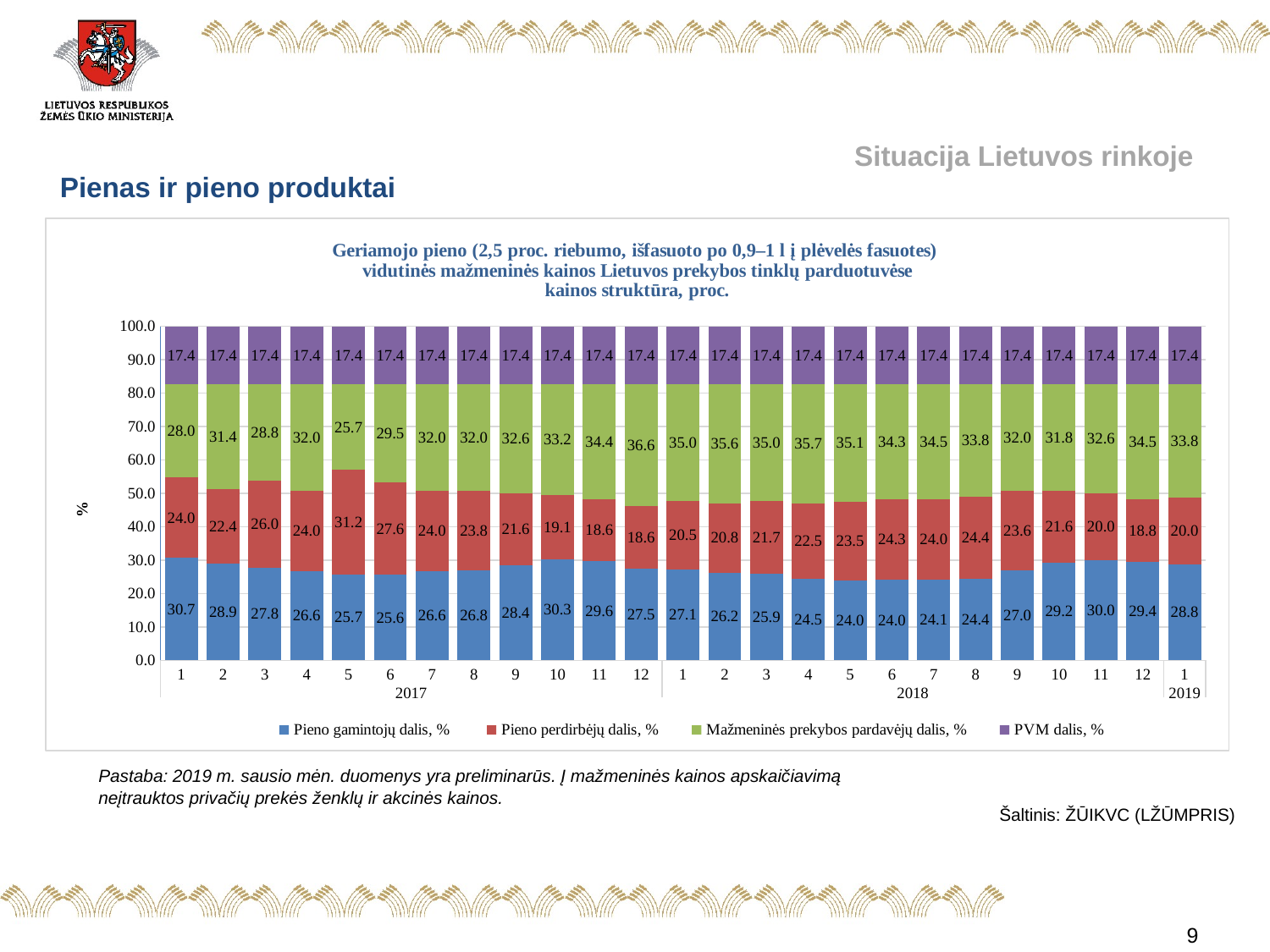
In which month and year is Mažmeninės prekybos pardavėjų dalis, % the lowest? Month 5 of 2017 Which is larger: Pieno perdirbėjų dalis, % in month 3 of 2017 or in month 3 of 2018? Month 3 of 2017 What is the difference between Pieno gamintojų dalis, % in month 1 of 2017 and month 5 of 2018? 6.7 What is the total of the stacked bar for month 1 of 2018? 100.0 What is the value of PVM dalis, % for month 1 of 2019? 17.4 What is the value of Mažmeninės prekybos pardavėjų dalis, % for month 12 of 2017? 36.6 What is the value of Pieno gamintojų dalis, % for month 1 of 2017? 30.7 How many bars (months) are shown in the chart? 25 What is the value of Pieno perdirbėjų dalis, % for month 5 of 2017? 31.2 In which month and year is Mažmeninės prekybos pardavėjų dalis, % the highest? Month 12 of 2017 How many series does the legend list? 4 What kind of chart is shown on the slide? Stacked bar chart